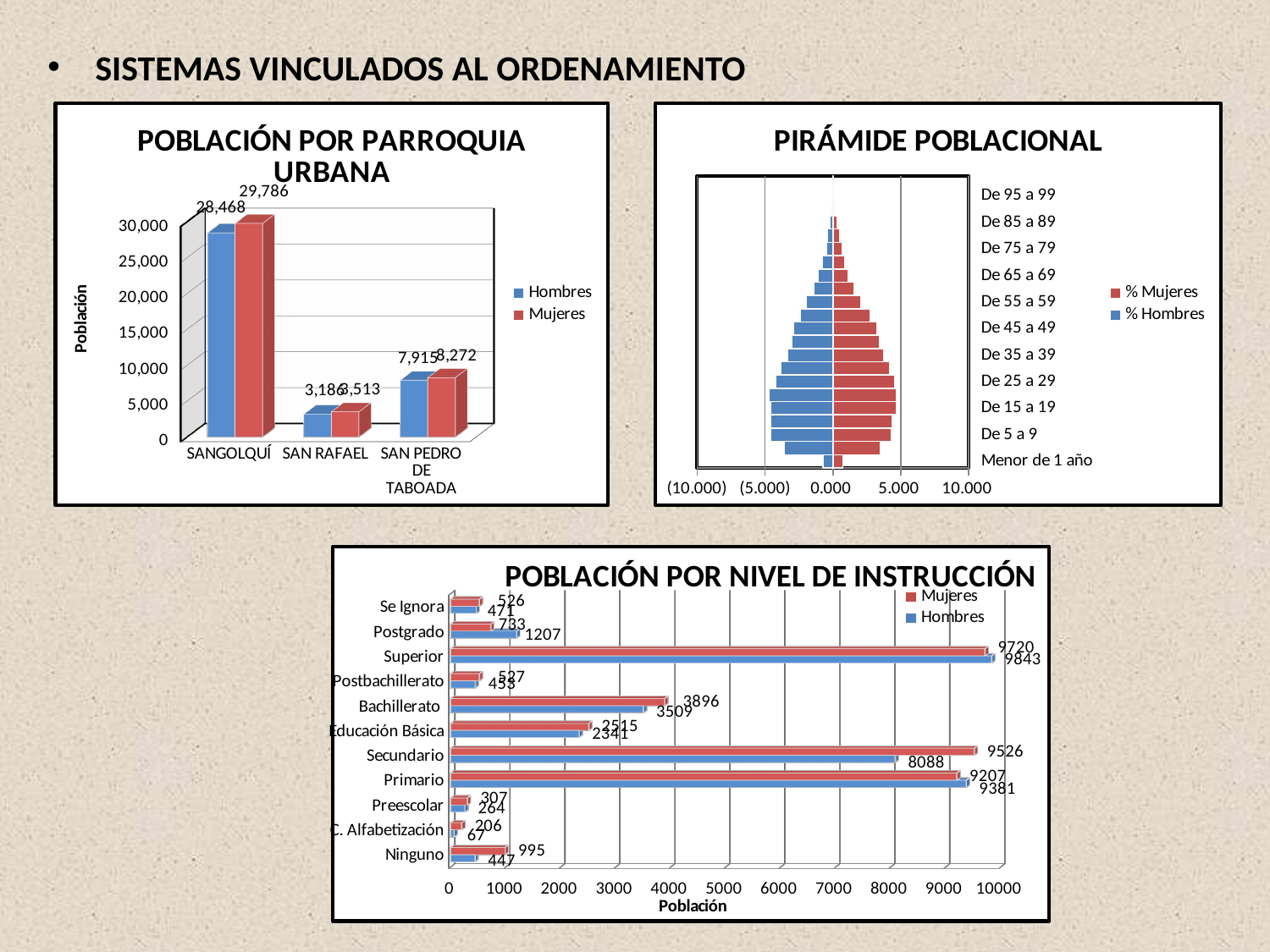
In the 'POBLACIÓN POR NIVEL DE INSTRUCCIÓN' chart, which level has the lowest Hombres value? C. Alfabetización In the 'POBLACIÓN POR PARROQUIA URBANA' chart, what is the difference between the Mujeres and Hombres values for SANGOLQUÍ? 1,318 In the 'POBLACIÓN POR PARROQUIA URBANA' chart, how many parroquias are shown on the x axis? 3 In the 'PIRÁMIDE POBLACIONAL' chart, how many series does the legend list? 2 In the 'POBLACIÓN POR PARROQUIA URBANA' chart, what is the Hombres value for SAN PEDRO DE TABOADA? 7,915 In the 'POBLACIÓN POR NIVEL DE INSTRUCCIÓN' chart, what is the Hombres value for Secundario? 8088 In the 'POBLACIÓN POR PARROQUIA URBANA' chart, what is the Mujeres value for SANGOLQUÍ? 29,786 In the 'POBLACIÓN POR NIVEL DE INSTRUCCIÓN' chart, which is larger for Ninguno, the Mujeres value or the Hombres value? Mujeres What kind of chart is 'PIRÁMIDE POBLACIONAL'? Bar chart (population pyramid) In the 'POBLACIÓN POR PARROQUIA URBANA' chart, which parroquia has the highest Hombres value? SANGOLQUÍ In the 'POBLACIÓN POR NIVEL DE INSTRUCCIÓN' chart, how many instruction levels are listed on the vertical axis? 11 In the 'POBLACIÓN POR NIVEL DE INSTRUCCIÓN' chart, what is the Mujeres value for Bachillerato? 3896